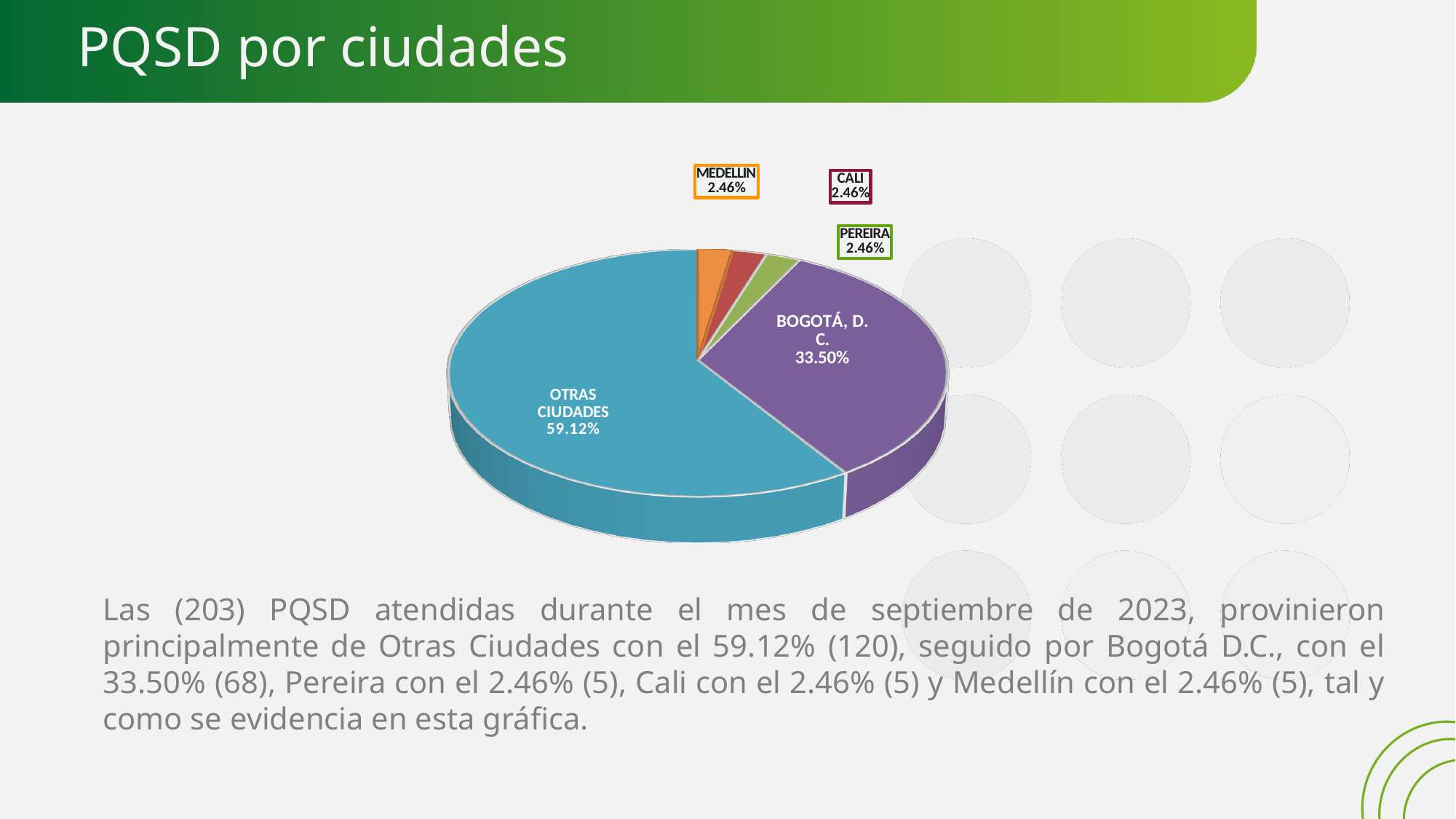
What share of the pie does OTRAS CIUDADES represent? 59.12% Which is larger, the slice for BOGOTÁ, D. C. or the slice for PEREIRA? BOGOTÁ, D. C. What colour is the OTRAS CIUDADES slice? Blue What is the difference in percentage points between OTRAS CIUDADES and BOGOTÁ, D. C.? 25.62 What share of the pie does MEDELLIN represent? 2.46% What share of the pie does CALI represent? 2.46% What share of the pie does BOGOTÁ, D. C. represent? 33.50% Which category has the largest slice of the pie? OTRAS CIUDADES What type of chart is shown on the slide? Pie chart What is the combined share of MEDELLIN, CALI and PEREIRA? 7.38% What share of the pie does PEREIRA represent? 2.46% How many slices does the pie chart have? 5